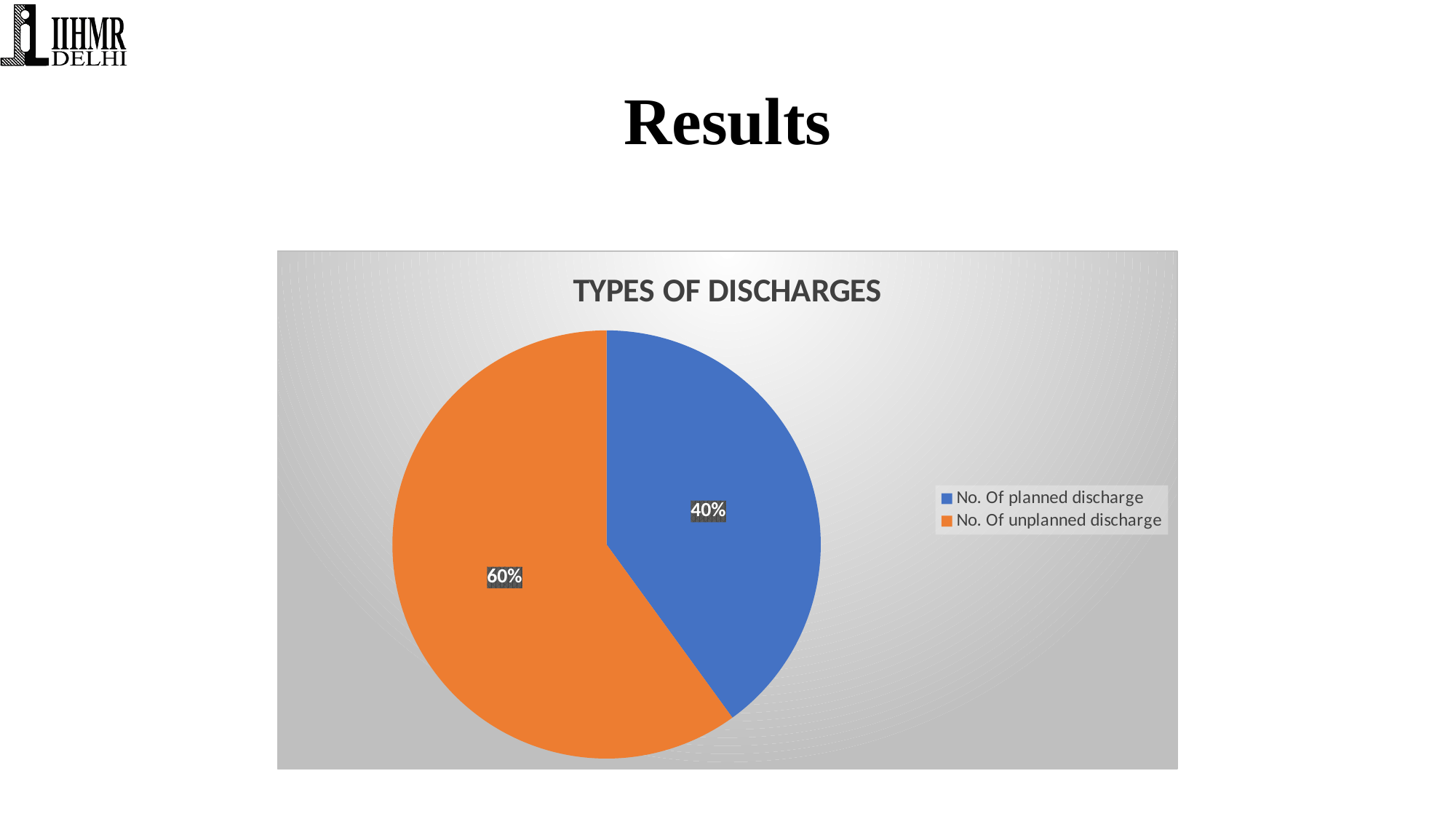
Which is larger: the slice for No. Of planned discharge or the slice for No. Of unplanned discharge? No. Of unplanned discharge How many slices does the pie chart have? 2 What share of the pie is labelled for No. Of unplanned discharge? 60% Which category has the smallest slice of the pie? No. Of planned discharge How many entries does the legend list? 2 Which category has the largest slice of the pie? No. Of unplanned discharge What is the title of the chart? TYPES OF DISCHARGES What share of the pie is labelled for No. Of planned discharge? 40% What type of chart is shown on the slide? pie chart What is the difference in percentage points between the unplanned and planned discharge slices? 20% What colour is the slice for No. Of unplanned discharge? orange